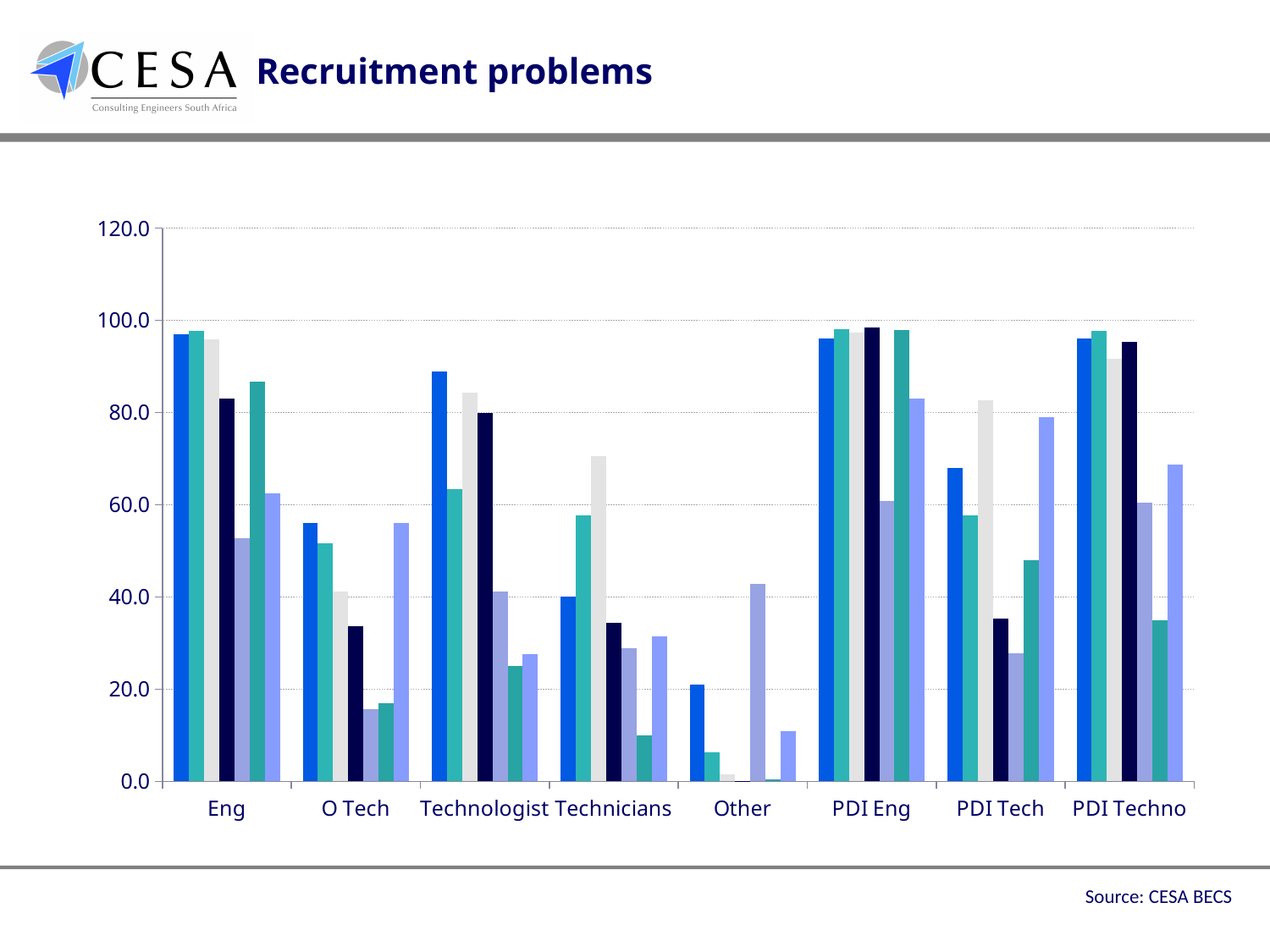
Is the value of the first (dark blue) bar for Eng greater or less than 80? greater What kind of chart is shown on the slide? bar chart What source is cited for the chart? CESA BECS Is the value of the first (dark blue) bar for PDI Tech greater or less than 60? greater Is the value of the first (dark blue) bar for Technologist greater or less than 80? greater How many categories are shown along the x axis of the chart? 8 Which is larger: the first (dark blue) bar for Eng or the first (dark blue) bar for O Tech? Eng How many bars are plotted for each category in the chart? 7 What is the title of the chart on the slide? Recruitment problems Which category has the lowest first (dark blue) bar? Other